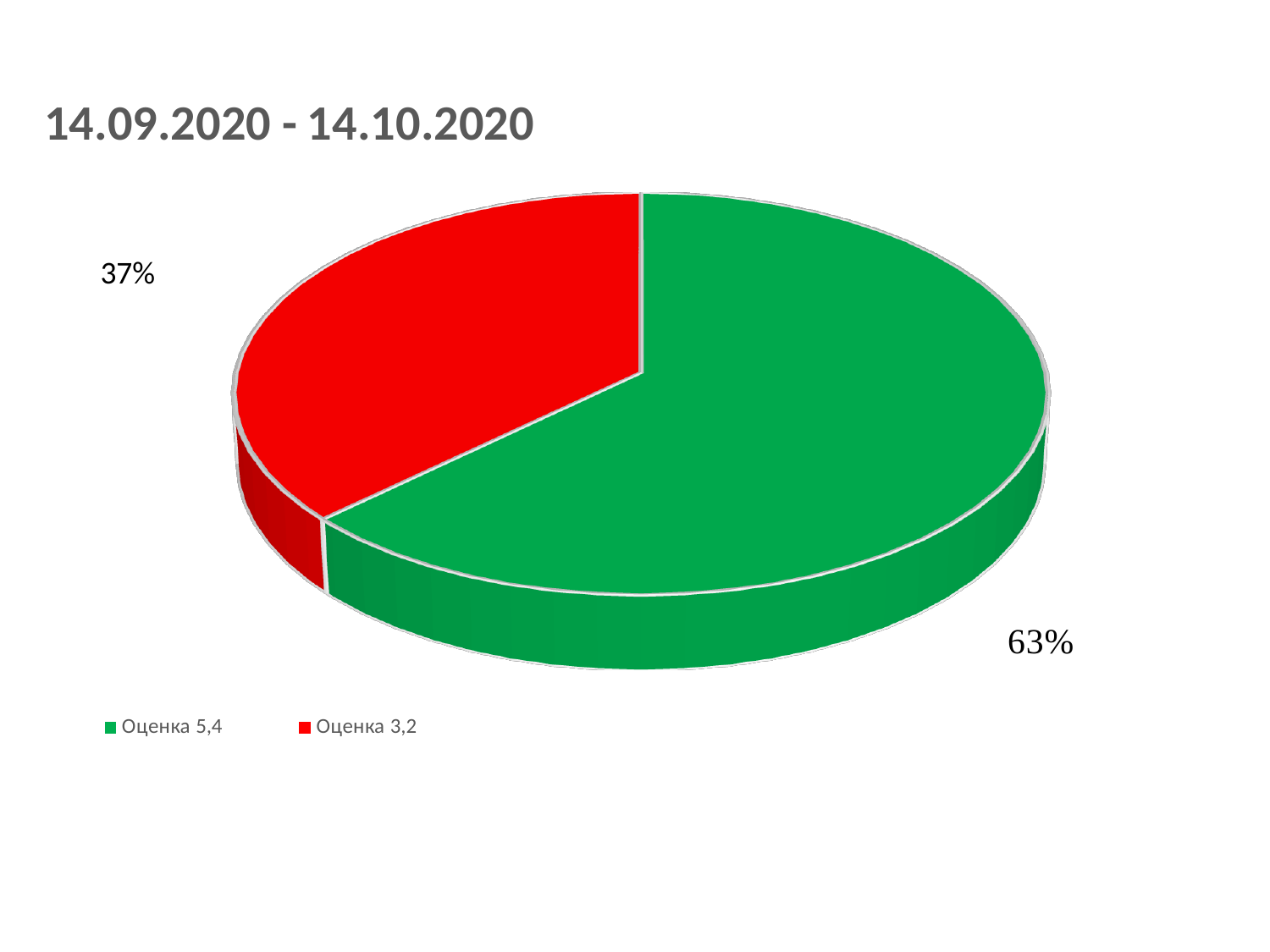
What is the difference in percentage points between the "Оценка 5,4" slice and the "Оценка 3,2" slice? 26 Which is larger, the "Оценка 5,4" slice or the "Оценка 3,2" slice? Оценка 5,4 What is the title of the chart? 14.09.2020 - 14.10.2020 Which category has the smallest slice of the pie? Оценка 3,2 Which category has the largest slice of the pie? Оценка 5,4 How many slices does the pie chart have? 2 What share of the pie does "Оценка 3,2" take? 37% What colour is the "Оценка 3,2" slice? red What share of the pie does "Оценка 5,4" take? 63% How many entries does the legend list? 2 What kind of chart is shown on the slide? pie chart